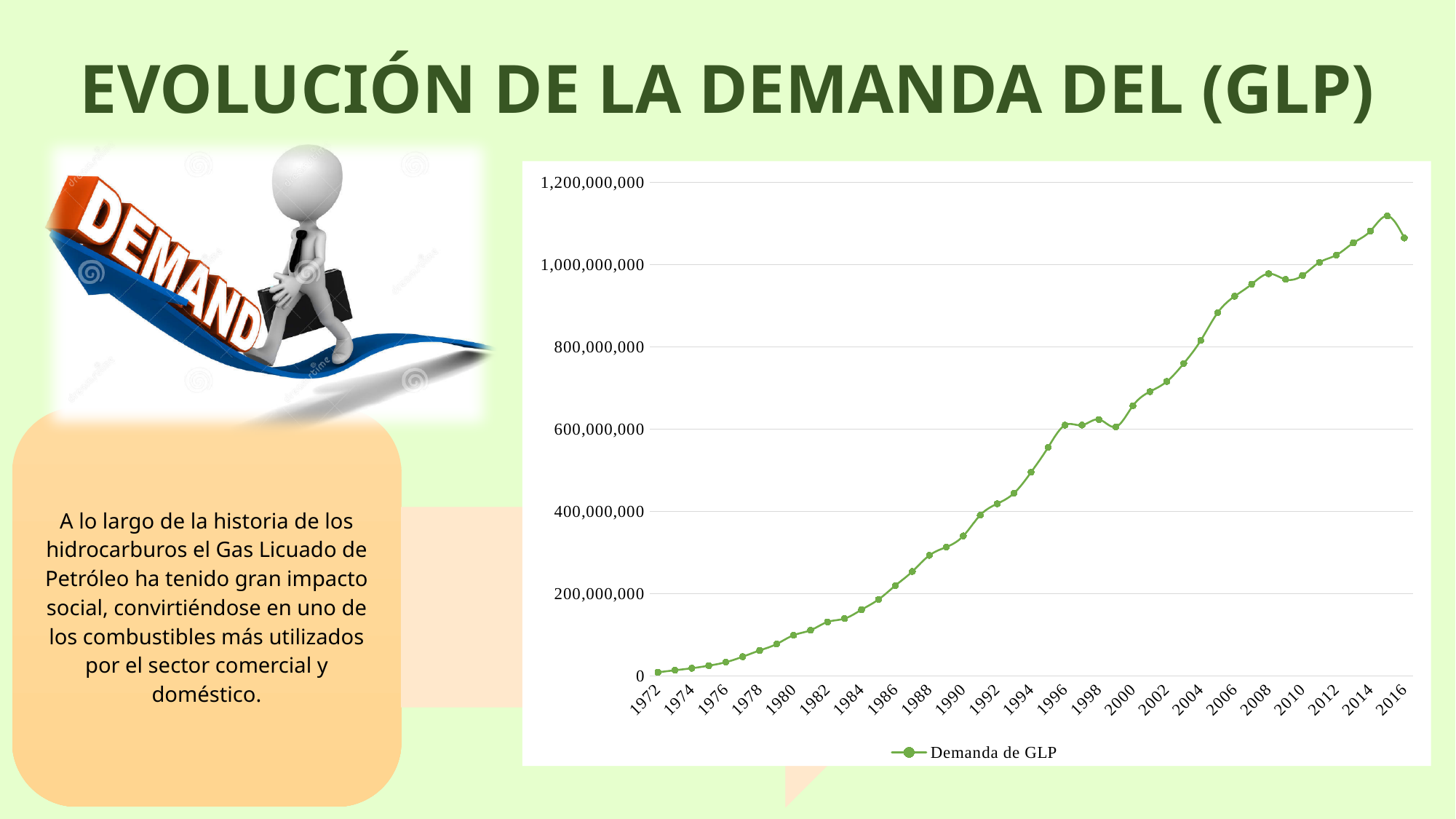
Is the value for Demanda de GLP in 1994 greater or less than 400,000,000? greater Is the value for Demanda de GLP in 1986 greater or less than 200,000,000? greater What is the highest value shown on the vertical axis of the chart? 1,200,000,000 Is the value for Demanda de GLP in 2016 greater or less than 1,000,000,000? greater Do the values of Demanda de GLP generally rise or fall from 1972 to 2016? rise How many series does the chart legend list? 1 What is the name of the series shown in the chart legend? Demanda de GLP Which year has the larger value for Demanda de GLP, 1990 or 2000? 2000 Which year has the lowest value for Demanda de GLP? 1972 What kind of chart is shown on the slide? line chart